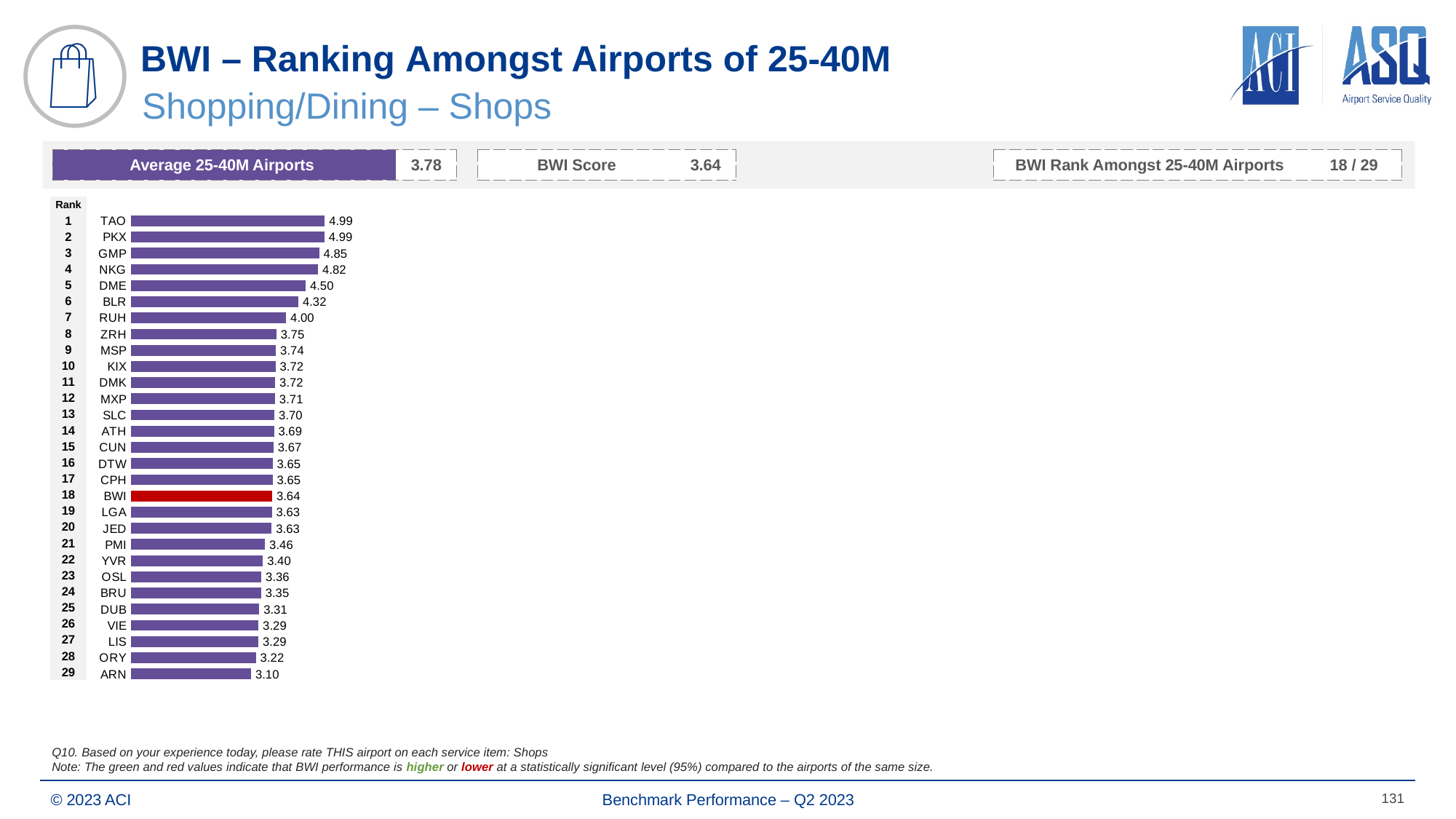
Which airport has the lowest value? ARN How many airports are shown in the chart? 29 What is the value for DME? 4.50 What is the value for BWI? 3.64 What rank does BWI hold amongst 25-40M airports? 18 / 29 Which is larger, the value for BLR or the value for PMI? BLR What is the difference between the values for TAO and ARN? 1.89 What kind of chart is shown on the slide? bar chart What is the difference between the values for RUH and BWI? 0.36 Which bar is coloured red in the chart? BWI Do the values rise or fall going down the ranked list from rank 1 to rank 29? fall What is the value for ARN? 3.10